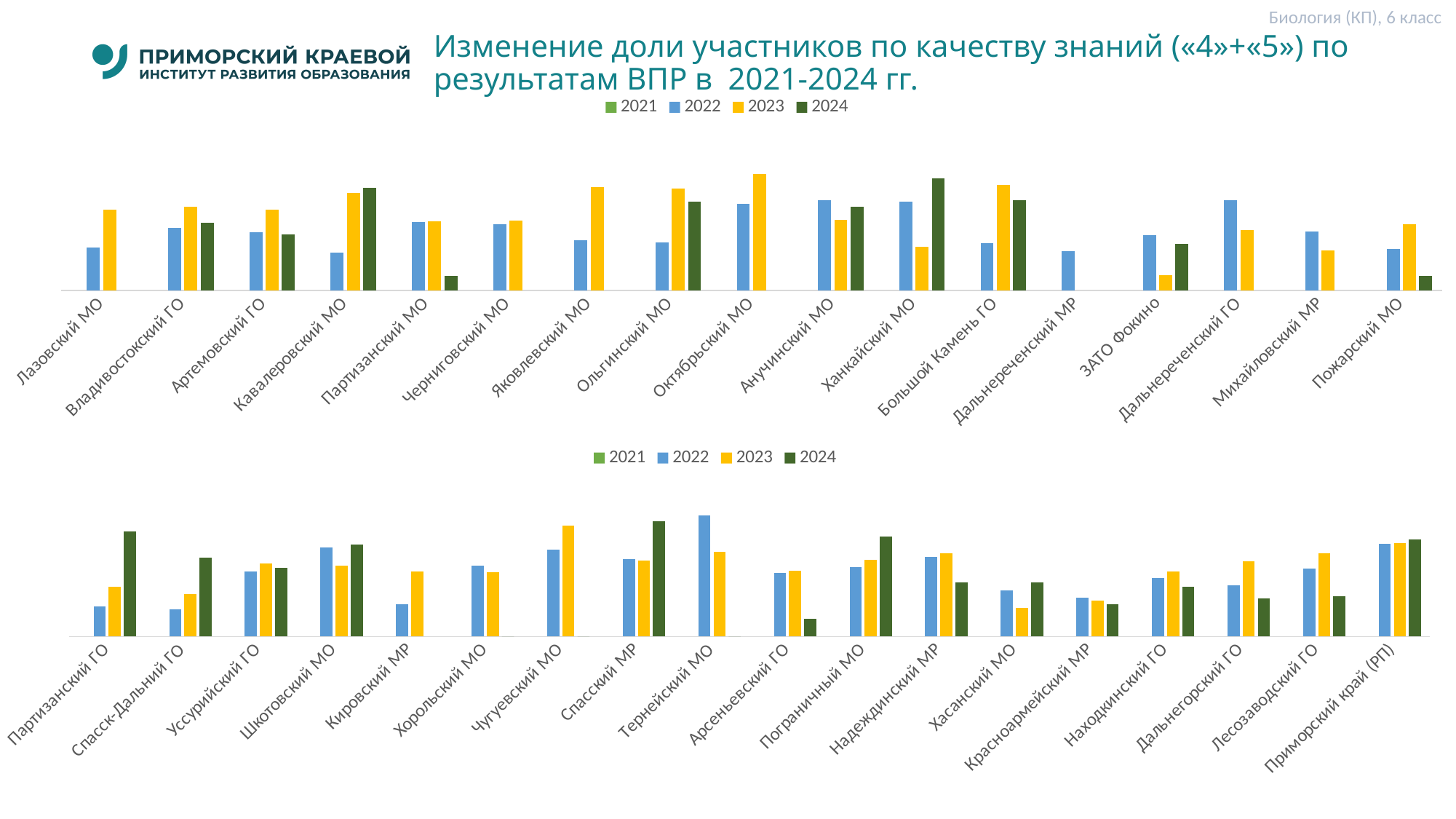
In the bottom chart, which year has the highest bar for Партизанский ГО? 2024 How many categories are shown on the x axis of the bottom chart? 18 In the bottom chart, which year has the lowest bar for Арсеньевский ГО? 2024 How many series does the legend of the top chart list? 4 Which colour represents the 2023 series in the legend of the charts? yellow In the top chart, for Партизанский МО, which is larger: the 2022 bar or the 2024 bar? 2022 What kind of chart is the top chart on the slide? bar chart In the bottom chart, for Тернейский МО, which is larger: the 2022 bar or the 2023 bar? 2022 In the top chart, for Лазовский МО, which is larger: the 2022 bar or the 2023 bar? 2023 In the top chart, which year has the highest bar for Ханкайский МО? 2024 In the top chart, which year has the highest bar for Октябрьский МО? 2023 How many categories are shown on the x axis of the top chart? 17